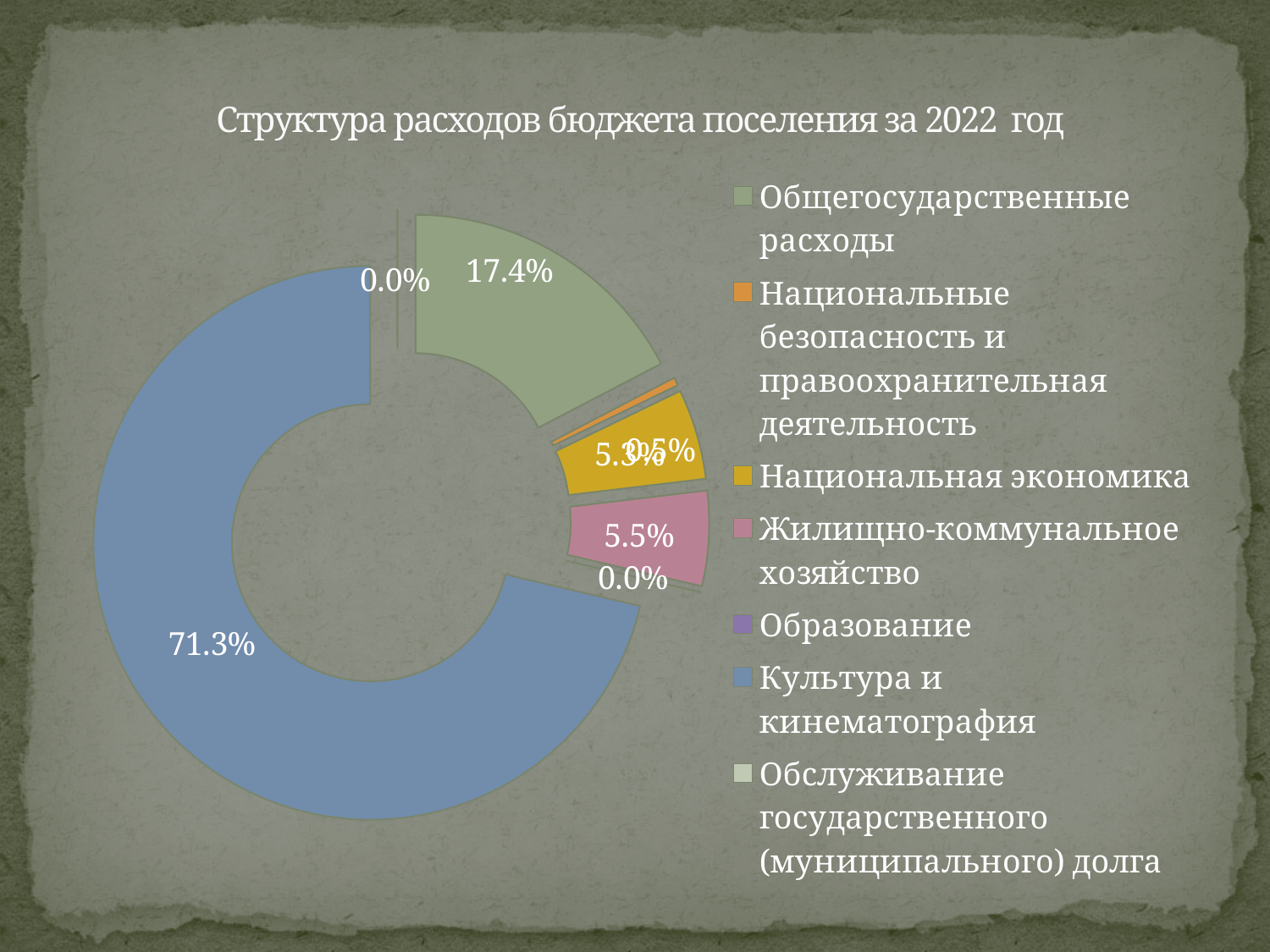
By how many percentage points does the share for Общегосударственные расходы exceed the share for Жилищно-коммунальное хозяйство? 11.9 Which is larger: the share for Общегосударственные расходы or the share for Жилищно-коммунальное хозяйство? Общегосударственные расходы What share of expenditure is labelled for Образование? 0.0% What share of expenditure is labelled for Общегосударственные расходы? 17.4% What share of expenditure is labelled for Культура и кинематография? 71.3% What kind of chart is shown on the slide? doughnut chart Which category has the largest share of the budget expenditure? Культура и кинематография What colour is the segment for Культура и кинематография? blue By how many percentage points does the share for Культура и кинематография exceed the share for Общегосударственные расходы? 53.9 How many categories does the legend list? 7 What share of expenditure is labelled for Жилищно-коммунальное хозяйство? 5.5% What is the title of the chart? Структура расходов бюджета поселения за 2022 год